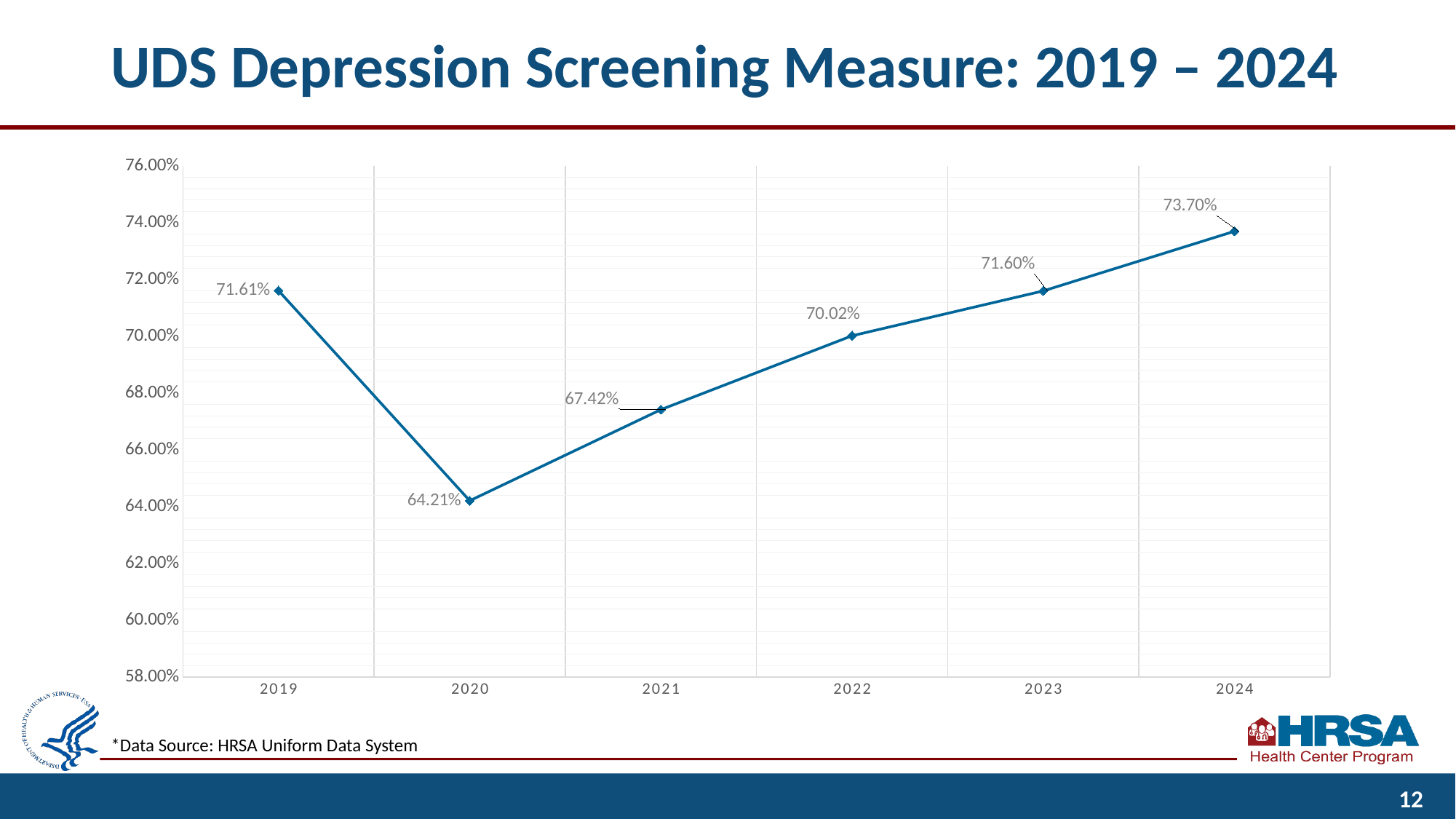
Which is larger, the value for 2021 or the value for 2022? 2022 What is the value for 2024? 73.70% What kind of chart is shown? line chart What is the value for 2019? 71.61% What is the difference between the 2024 value and the 2020 value? 9.49% Which year has the lowest value? 2020 Is the value for 2023 greater or less than 70.00%? greater What is the value for 2020? 64.21% What is the value for 2022? 70.02% How many years are plotted on the chart? 6 Do the values rise or fall from 2020 to 2024? rise Which year has the highest value? 2024